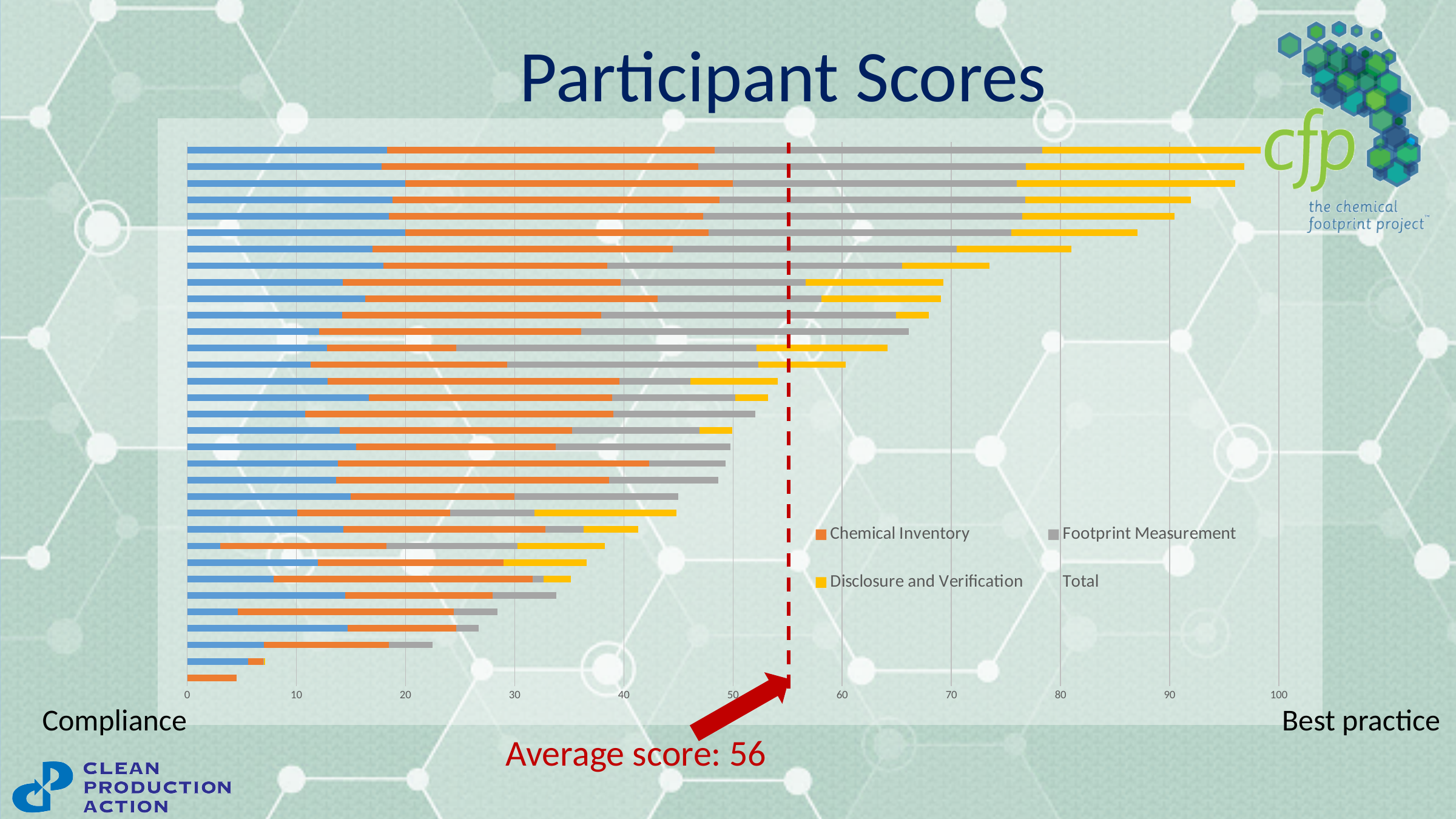
How many series does the legend list? 4 What kind of chart is shown on the slide? Stacked bar chart Is the total score of the bottommost bar greater or less than 10? less Is the total score of the topmost bar greater or less than the average score of 56? greater Which series is shown in orange according to the legend? Chemical Inventory Is the total score of the topmost bar greater or less than 90? greater Do the total scores of the bars increase or decrease going from the top of the chart to the bottom? decrease What average score is marked by the red dashed line on the chart? 56 What is the title of the chart? Participant Scores Which bar has the highest total score, the topmost bar or the bottommost bar? the topmost bar What is the highest value shown on the horizontal axis? 100